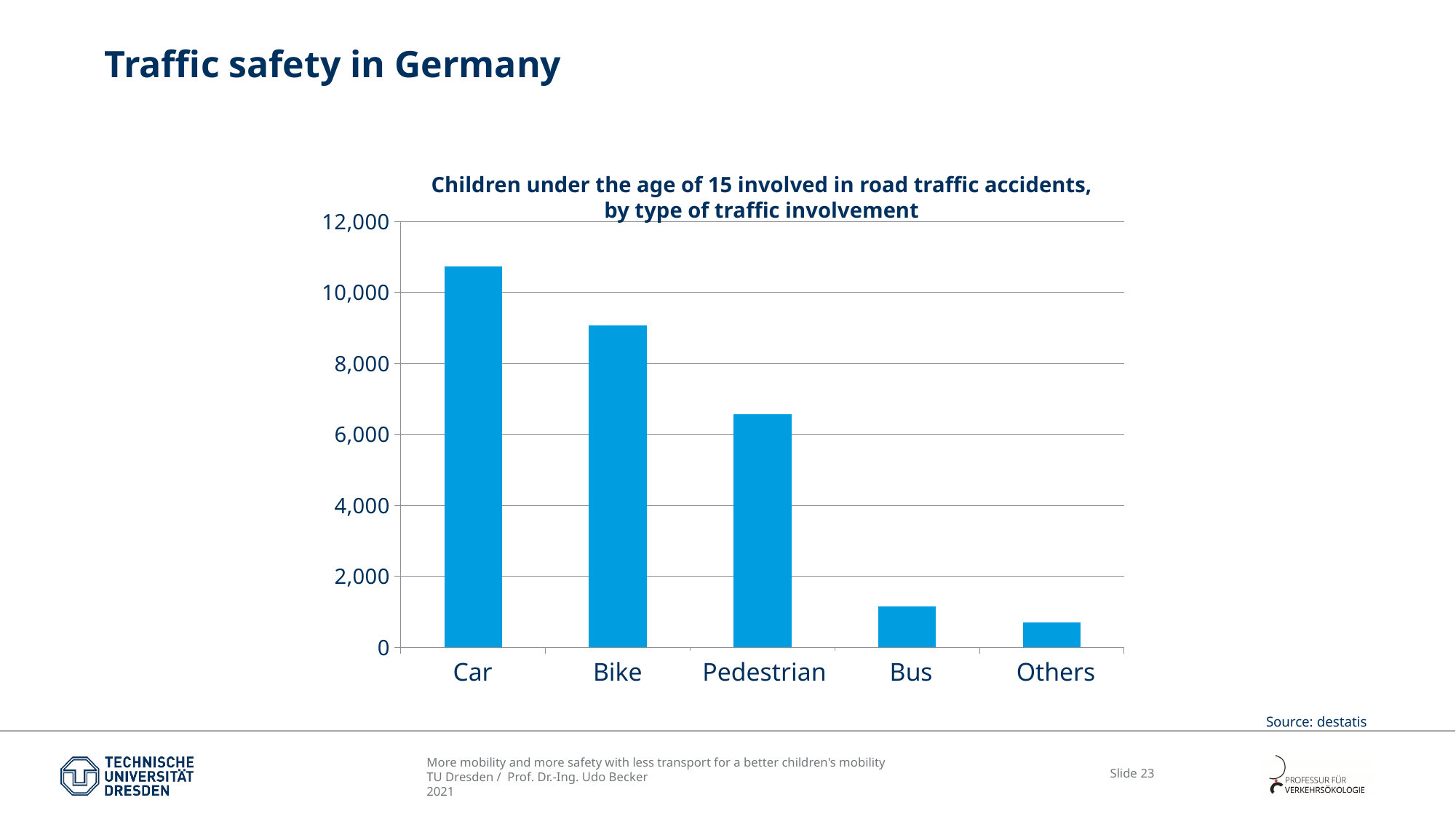
Is the value for Pedestrian greater or less than 8,000? less Which is larger, the value for Bus or the value for Others? Bus Do the values rise or fall from left to right along the x axis? fall Is the value for Car greater or less than 10,000? greater Which is larger, the value for Bike or the value for Pedestrian? Bike How many types of traffic involvement are shown on the x axis? 5 What kind of chart is shown on the slide? bar chart What is the title of the chart? Children under the age of 15 involved in road traffic accidents, by type of traffic involvement Which type of traffic involvement has the highest number of children involved in road traffic accidents? Car Is the value for Bus greater or less than 2,000? less Which type of traffic involvement has the lowest number of children involved in road traffic accidents? Others